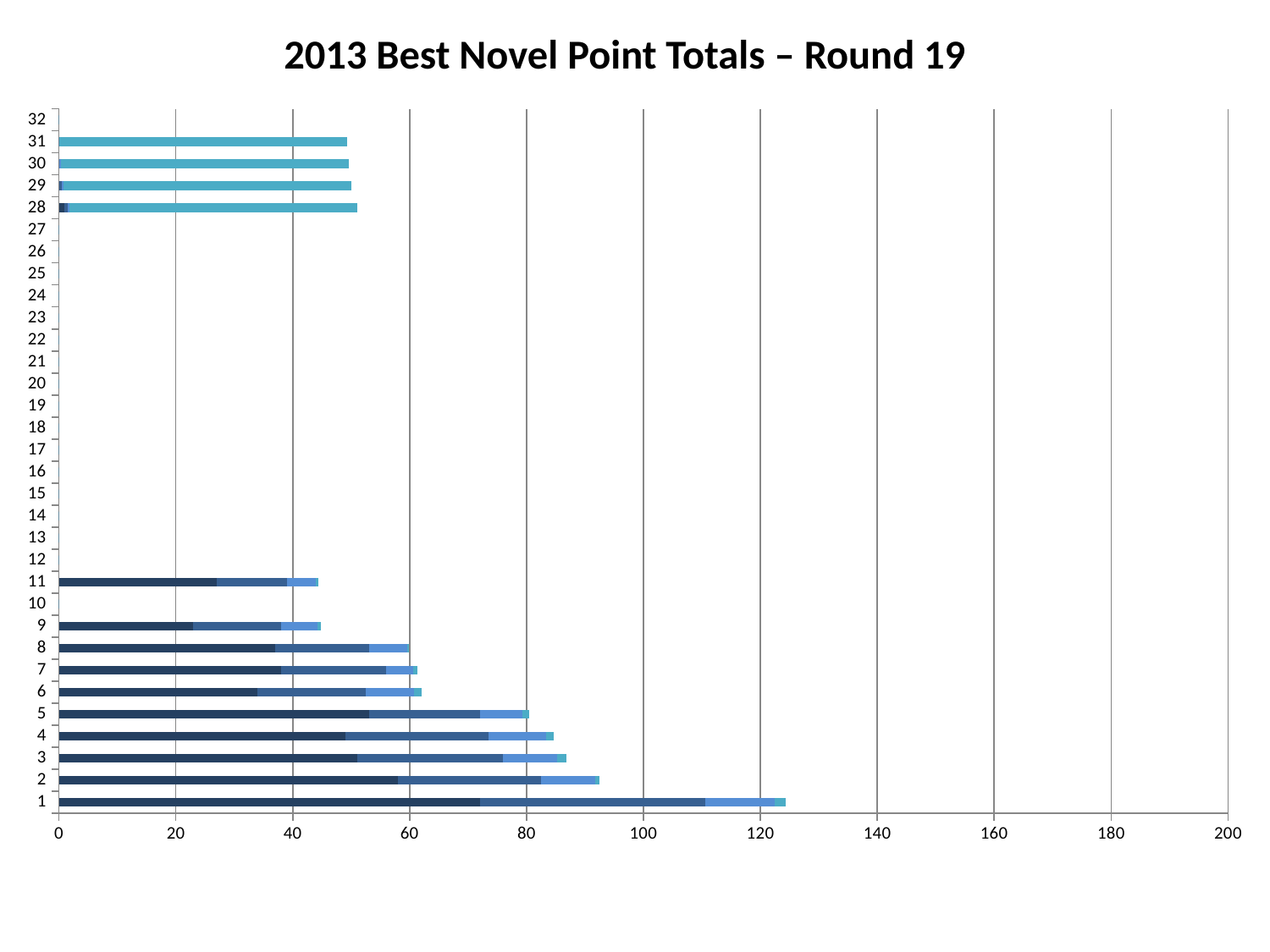
Is the total for category 11 greater or less than 60? less What is the highest value shown on the horizontal axis? 200 Which category has the highest total on the chart? 1 What is the title of the chart? 2013 Best Novel Point Totals – Round 19 How many categories are labelled on the vertical axis? 32 Is the total for category 28 greater or less than 60? less Which has the larger total, category 2 or category 5? 2 Is the total for category 1 greater or less than 100? greater What kind of chart is shown on the slide? bar chart